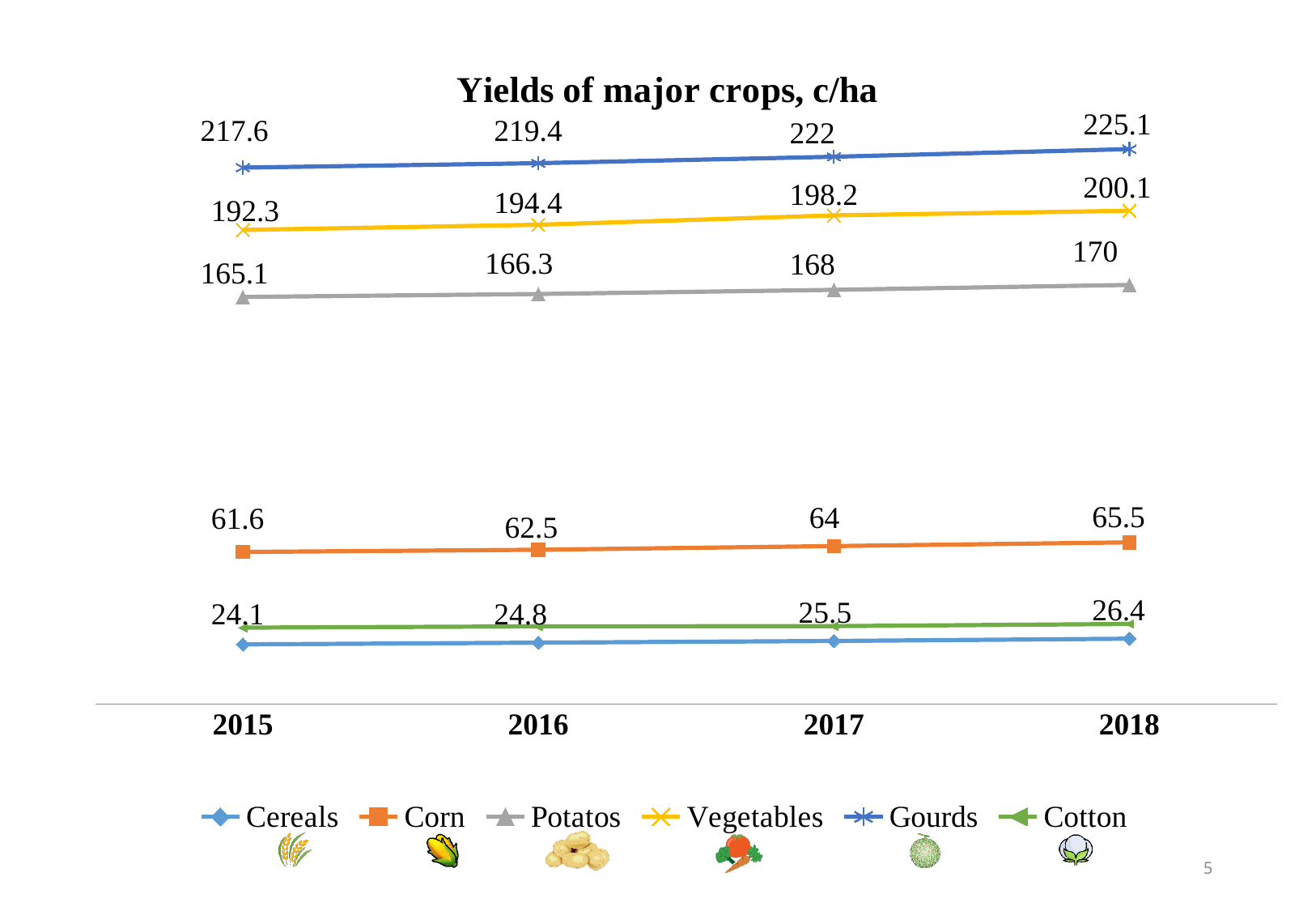
How many series does the legend list? 6 What is the difference between the Vegetables yield in 2018 and in 2017? 1.9 What is the yield of Gourds in 2018? 225.1 How many years are shown on the x axis? 4 What kind of chart is shown on the slide? Line chart What is the yield of Corn in 2016? 62.5 Which crop has the lowest yield across the years shown? Cereals What is the yield of Potatos in 2015? 165.1 What is the yield of Vegetables in 2017? 198.2 Which is larger in 2017, the yield of Corn or the yield of Potatos? Potatos By how much did the yield of Gourds increase from 2015 to 2018? 7.5 Which crop has the highest yield in 2018? Gourds